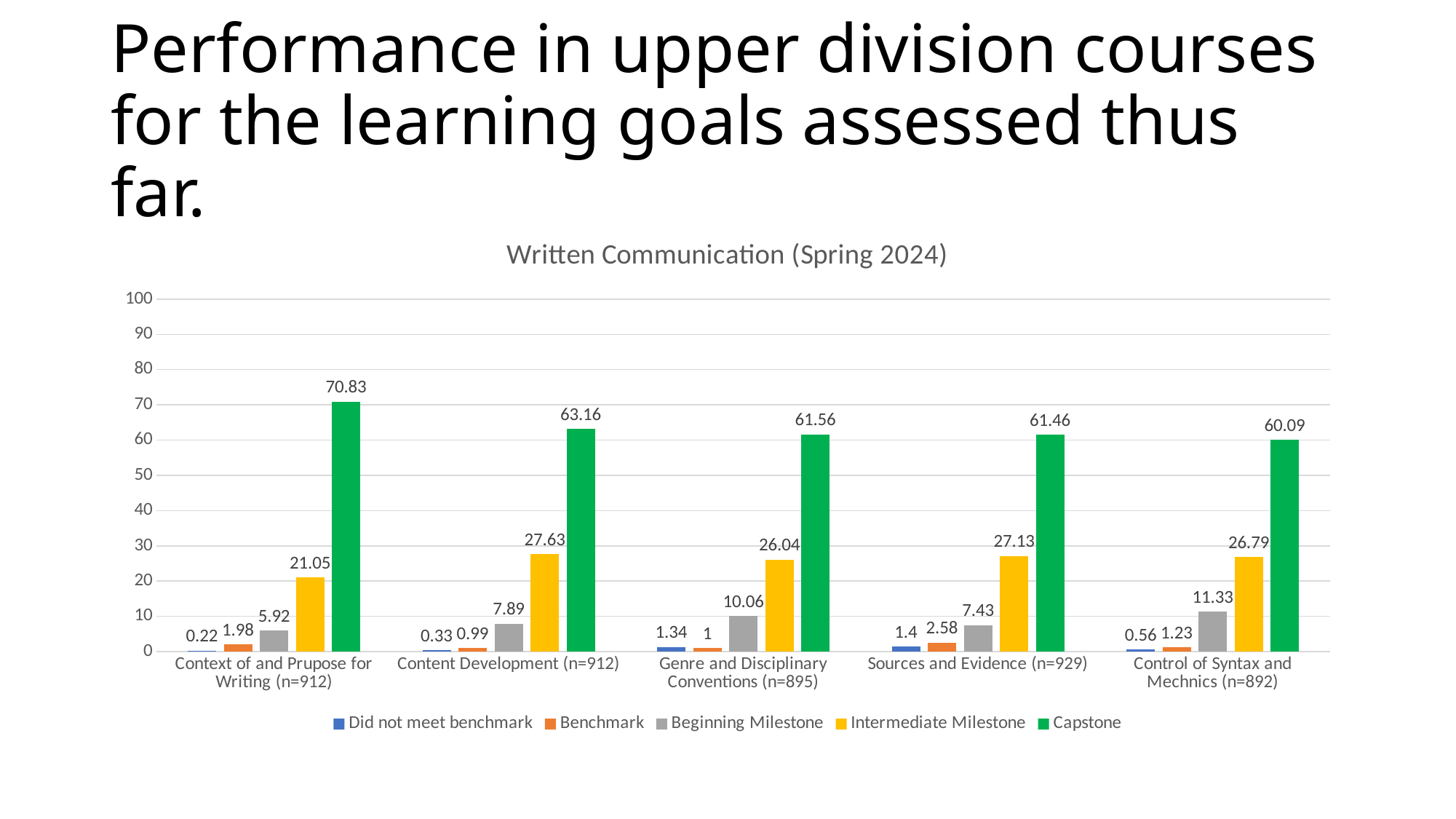
What is the title of the chart? Written Communication (Spring 2024) What is the Intermediate Milestone value for Content Development (n=912)? 27.63 What is the difference between the Capstone values for Context of and Prupose for Writing (n=912) and Content Development (n=912)? 7.67 How many categories are shown on the x axis? 5 How many series does the legend list? 5 Which is larger: the Beginning Milestone value for Control of Syntax and Mechnics (n=892) or for Sources and Evidence (n=929)? Control of Syntax and Mechnics (n=892) Which category has the highest Capstone value? Context of and Prupose for Writing (n=912) Is the Capstone value for Genre and Disciplinary Conventions (n=895) greater or less than 50? greater What is the Beginning Milestone value for Genre and Disciplinary Conventions (n=895)? 10.06 What is the Did not meet benchmark value for Sources and Evidence (n=929)? 1.4 What is the Capstone value for Context of and Prupose for Writing (n=912)? 70.83 Which category has the lowest Capstone value? Control of Syntax and Mechnics (n=892)